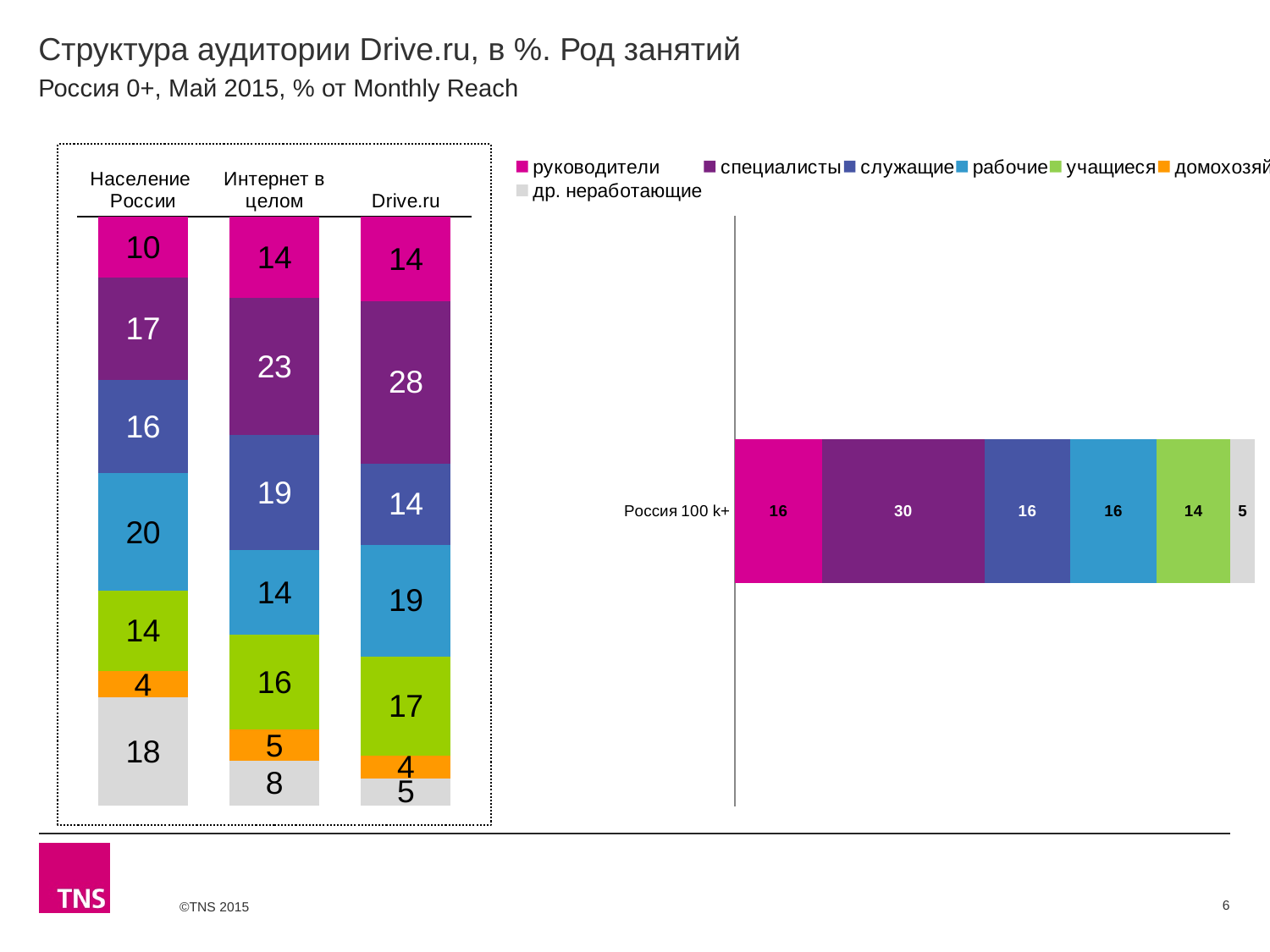
In the left chart, what is the value for рабочие in the Население России bar? 20 How many series does the legend list? 7 What type of chart is the right chart (Россия 100 k+)? Stacked bar chart In the right chart (Россия 100 k+), what is the value for учащиеся? 14 In the right chart (Россия 100 k+), what is the value for специалисты? 30 In the left chart, which occupation group has the smallest share in the Население России bar? домохозяйки In the left chart, what is the value for др. неработающие in the Интернет в целом bar? 8 In the left chart, what is the value for специалисты in the Drive.ru bar? 28 How many bars (audience groups) does the left chart show? 3 In the left chart, what is the difference between the специалисты values for Drive.ru and Население России? 18 In the left chart, which is larger: the учащиеся value for Drive.ru or for Интернет в целом? Drive.ru In the left chart, which occupation group has the largest share in the Drive.ru bar? специалисты